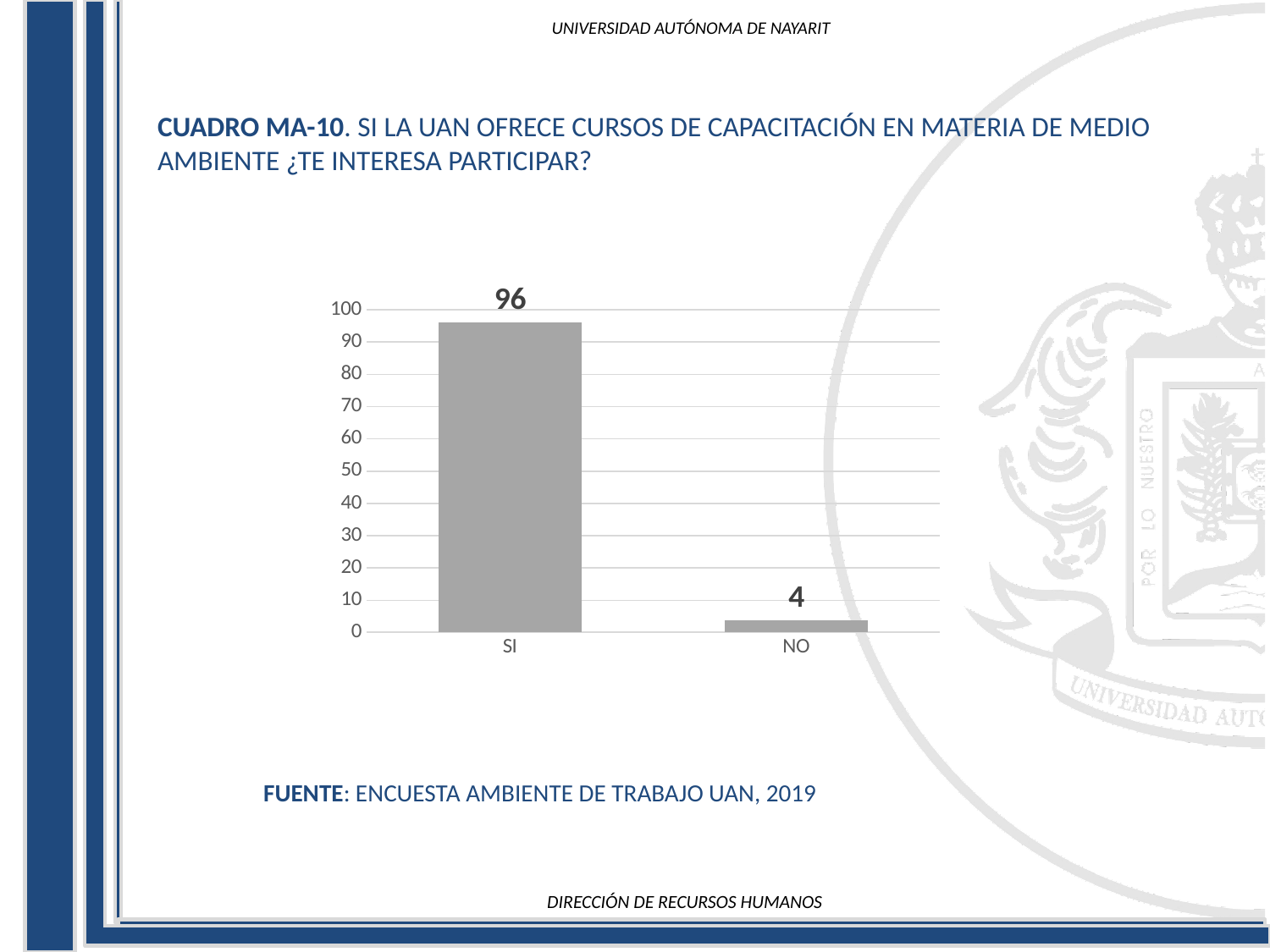
Is the value for SI greater or less than 90? greater What is the highest value shown on the vertical axis? 100 What is the value for NO? 4 What is the difference between the values for SI and NO? 92 Is the value for NO greater or less than 10? less How many categories are shown on the x axis? 2 What kind of chart is shown on the slide? bar chart What is the total of the values for SI and NO? 100 What is the value for SI? 96 Which category has the lowest value? NO Which is larger, the value for SI or the value for NO? SI Which category has the highest value? SI